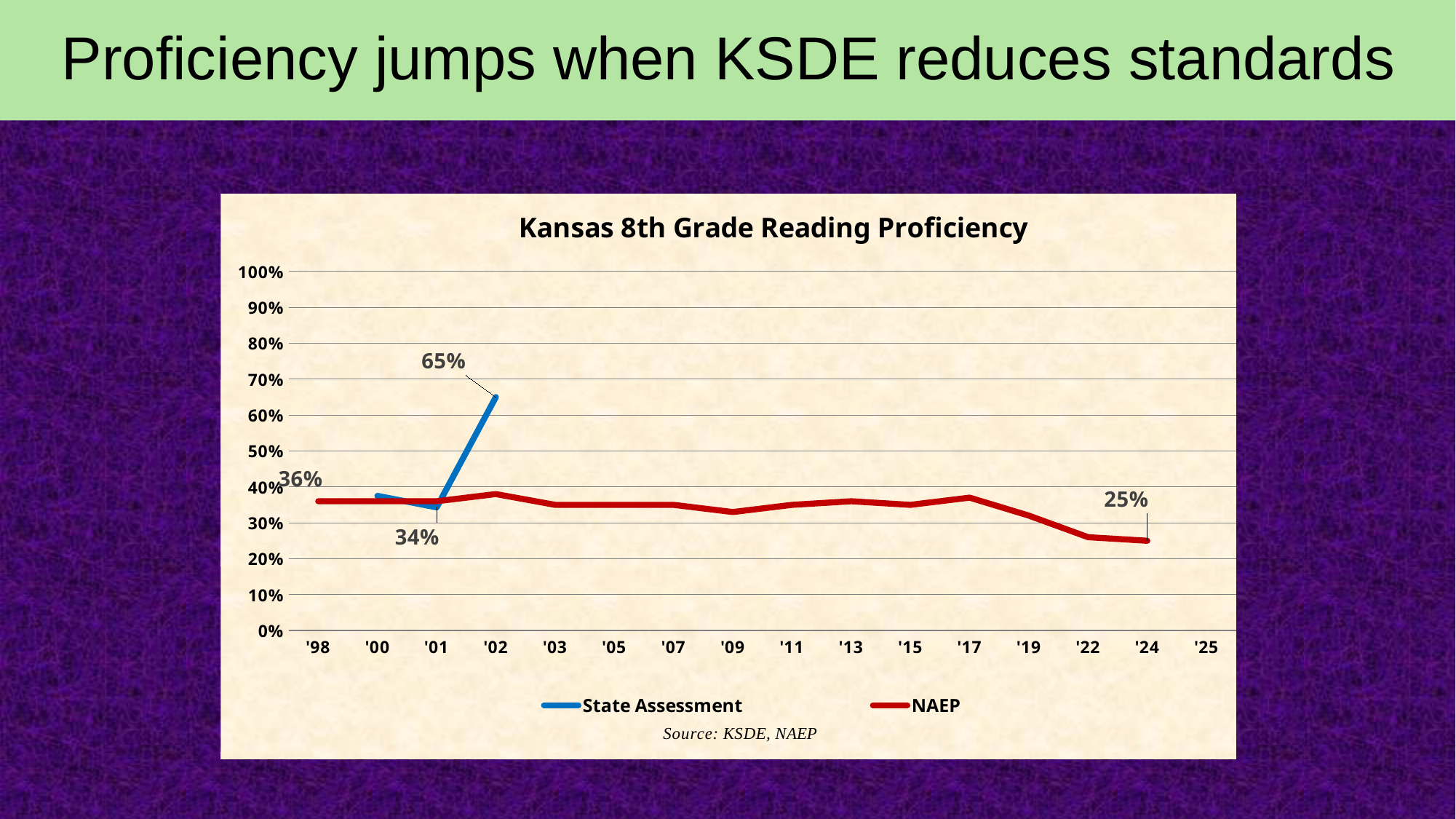
What kind of chart is shown on the slide? line chart What is the title of the chart? Kansas 8th Grade Reading Proficiency What is the NAEP proficiency value for '24? 25% What is the State Assessment proficiency value for '02? 65% How many series does the legend list? 2 What is the NAEP proficiency value for '98? 36% Does the NAEP line rise or fall from '17 to '24? fall What is the State Assessment proficiency value for '01? 34% By how many percentage points did the NAEP value fall from '98 to '24? 11 percentage points Which is larger: the State Assessment value in '02 or the NAEP value in '24? State Assessment in '02 Is the NAEP value for '22 greater or less than 30%? less By how many percentage points did the State Assessment value rise from '01 to '02? 31 percentage points